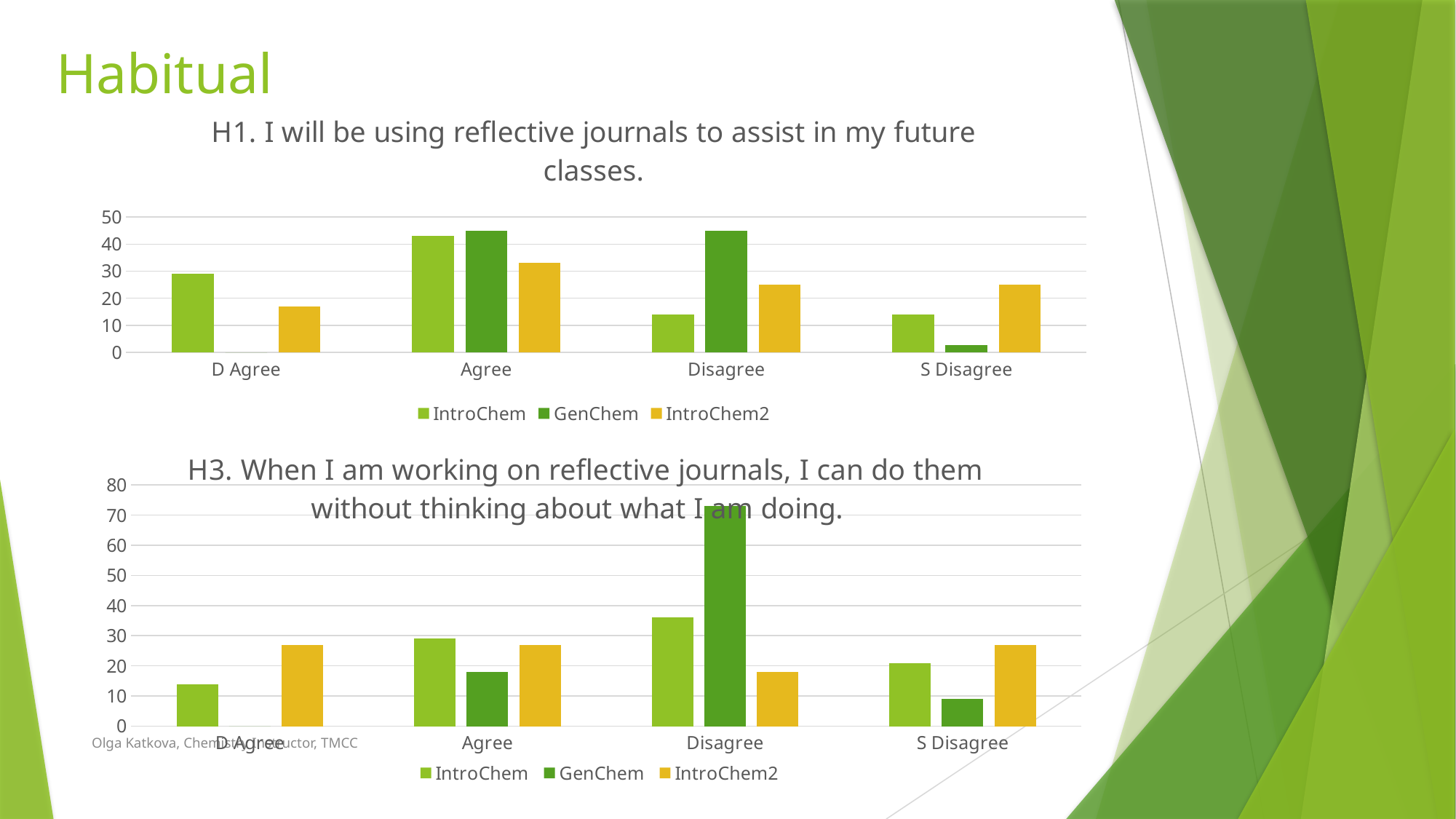
In the H1 chart, is the IntroChem value for D Agree greater or less than 20? greater In the H3 chart, which category has the highest GenChem value? Disagree In the H1 chart, for Agree, which is larger: GenChem or IntroChem2? GenChem In the H3 chart, for Disagree, which is larger: IntroChem or IntroChem2? IntroChem In the H1 chart, is the GenChem value for S Disagree greater or less than 10? less What colour represents the IntroChem2 series in the legends? yellow In the H1 chart, which category has the highest IntroChem value? Agree How many response categories are shown on the x axis of the H3 chart? 4 What kind of chart is the H1 chart at the top of the slide? bar chart In the H3 chart, which category has the lowest IntroChem value? D Agree In the H3 chart, is the GenChem value for Disagree greater or less than 60? greater How many series does the legend of the H1 chart list? 3